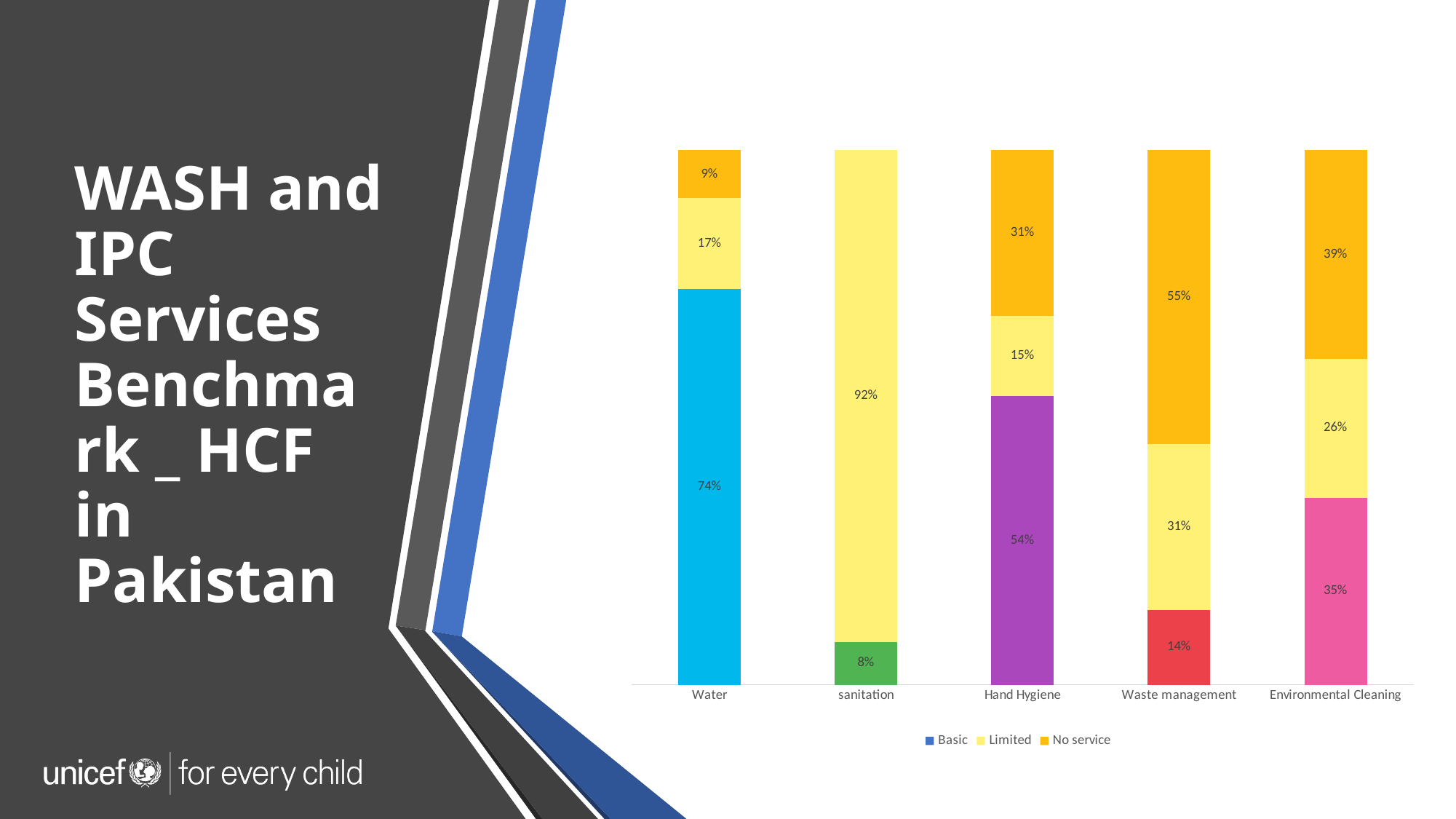
Which category has the highest No service value? Waste management What is the Basic value for Water? 74% What is the No service value for Environmental Cleaning? 39% How many categories are shown along the x axis of the chart? 5 How many series does the chart legend list? 3 What is the Limited value for sanitation? 92% What is the Limited value for Hand Hygiene? 15% What is the difference between the No service values for Waste management and Water? 46% Which category has the lowest Limited value? Hand Hygiene What is the No service value for Waste management? 55% What type of chart is shown on the slide? stacked bar chart Which is larger, the Limited value for Waste management or the Limited value for Environmental Cleaning? Waste management